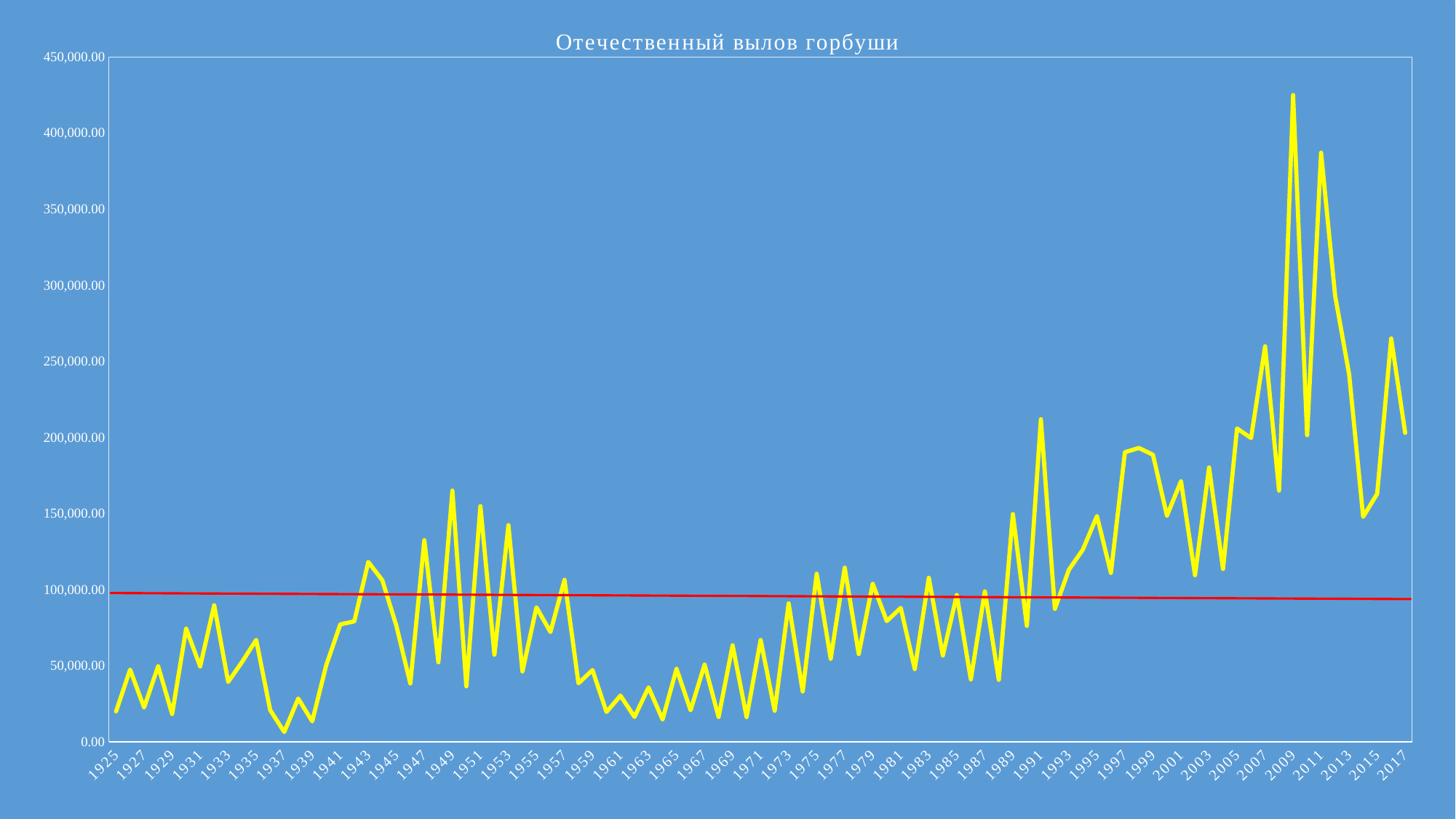
Is the value for 1949 greater or less than 150,000.00? greater In which year does the yellow line reach its lowest value? 1937 What is the title of the chart? Отечественный вылов горбуши What kind of chart is shown on the slide? line chart In which year does the yellow line reach its highest value? 2009 Which year has the larger value, 2009 or 2011? 2009 Is the value for 2009 greater or less than 400,000.00? greater Is the value for 1961 greater or less than 50,000.00? less Which year has the larger value, 2007 or 2015? 2007 What colour is the main data line in the chart? yellow